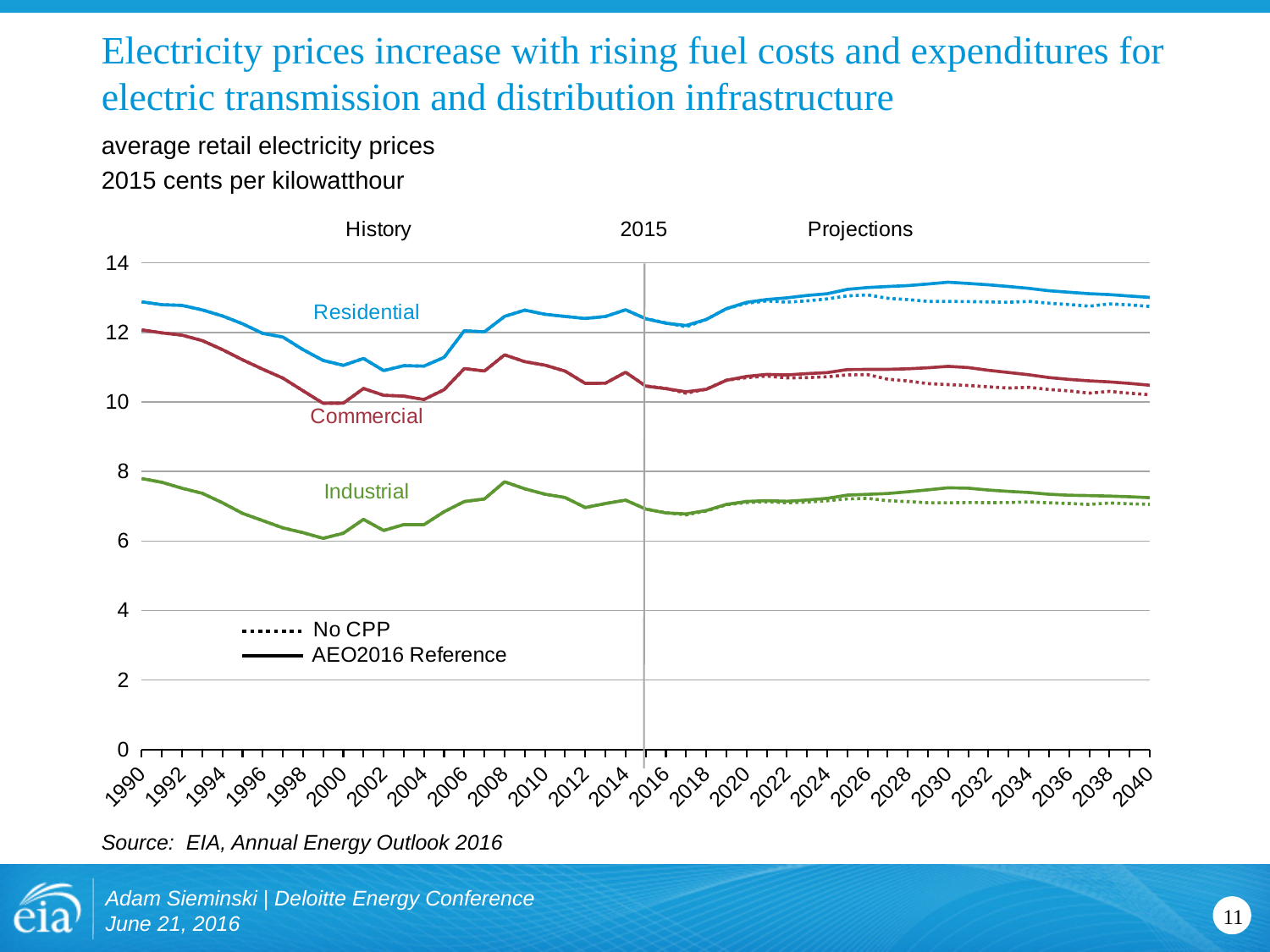
Is the Residential AEO2016 Reference price in 2030 greater or less than 12? greater Which sector has the lowest average retail electricity price across the whole period? Industrial In 2040, which is higher for the Residential sector, the AEO2016 Reference line or the No CPP line? AEO2016 Reference How many line styles does the legend list? 2 Which line style represents the No CPP case? dotted Is the Residential price in 1990 greater or less than 12? greater What year does the vertical line separating History from Projections mark? 2015 Is the Industrial price in 2000 greater or less than 8? less Does the Residential price rise or fall between 1990 and 2000? fall Which sector has the highest average retail electricity price across the whole period? Residential What kind of chart is shown on the slide? line chart